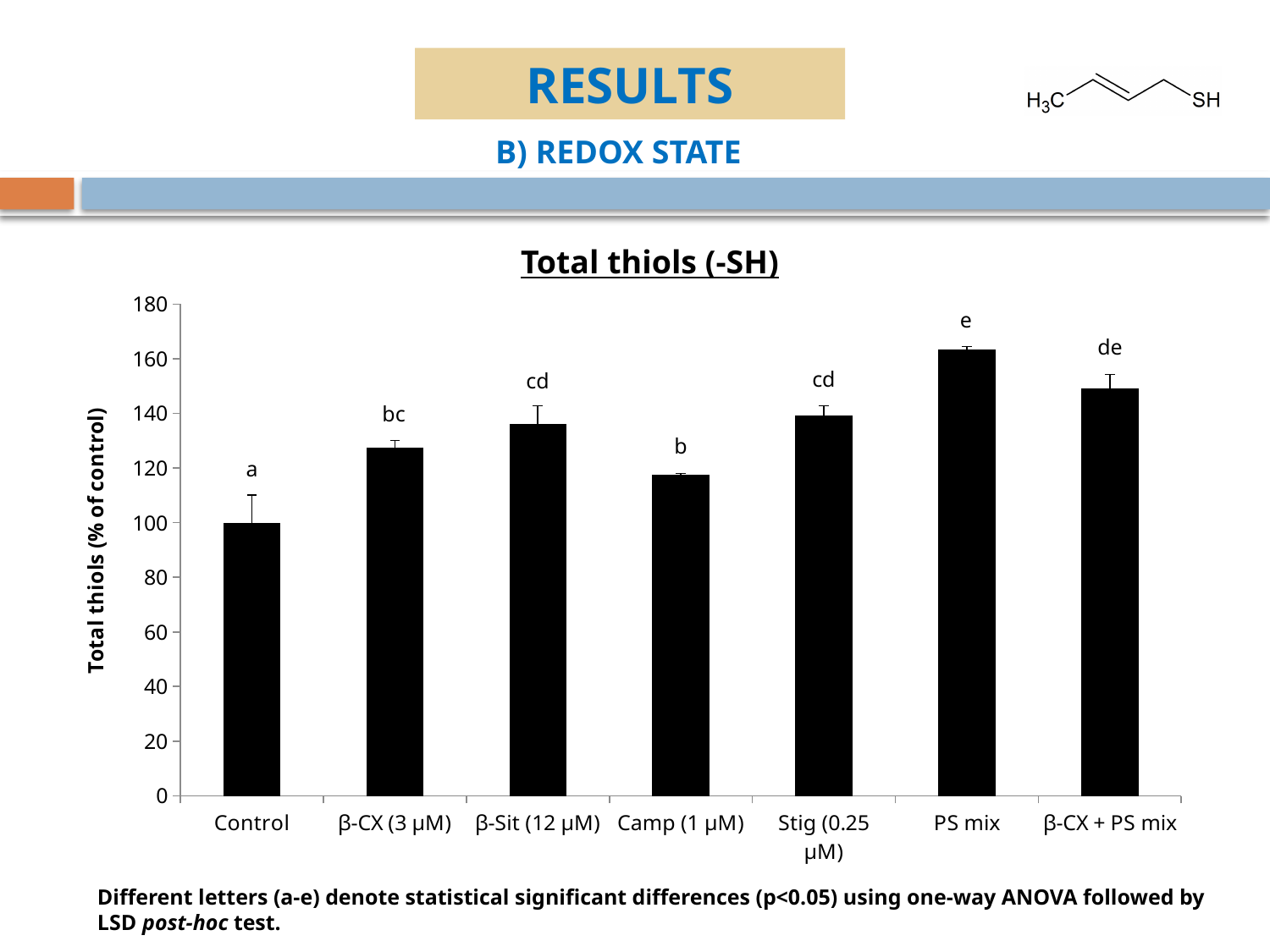
Which category has the highest total thiols value? PS mix Which has the larger total thiols value, PS mix or Control? PS mix What is the total thiols value (% of control) for Control? 100 Which category has the lowest total thiols value? Control Which has the larger total thiols value, Camp (1 µM) or β-CX (3 µM)? β-CX (3 µM) Is the value for β-CX + PS mix greater or less than 140? greater What is the y-axis label of the chart? Total thiols (% of control) Is the value for Camp (1 µM) greater or less than 120? less What is the title of the chart? Total thiols (-SH) What kind of chart is shown on the slide? bar chart How many categories are plotted on the x axis of the Total thiols (-SH) chart? 7 Is the value for PS mix greater or less than 140? greater